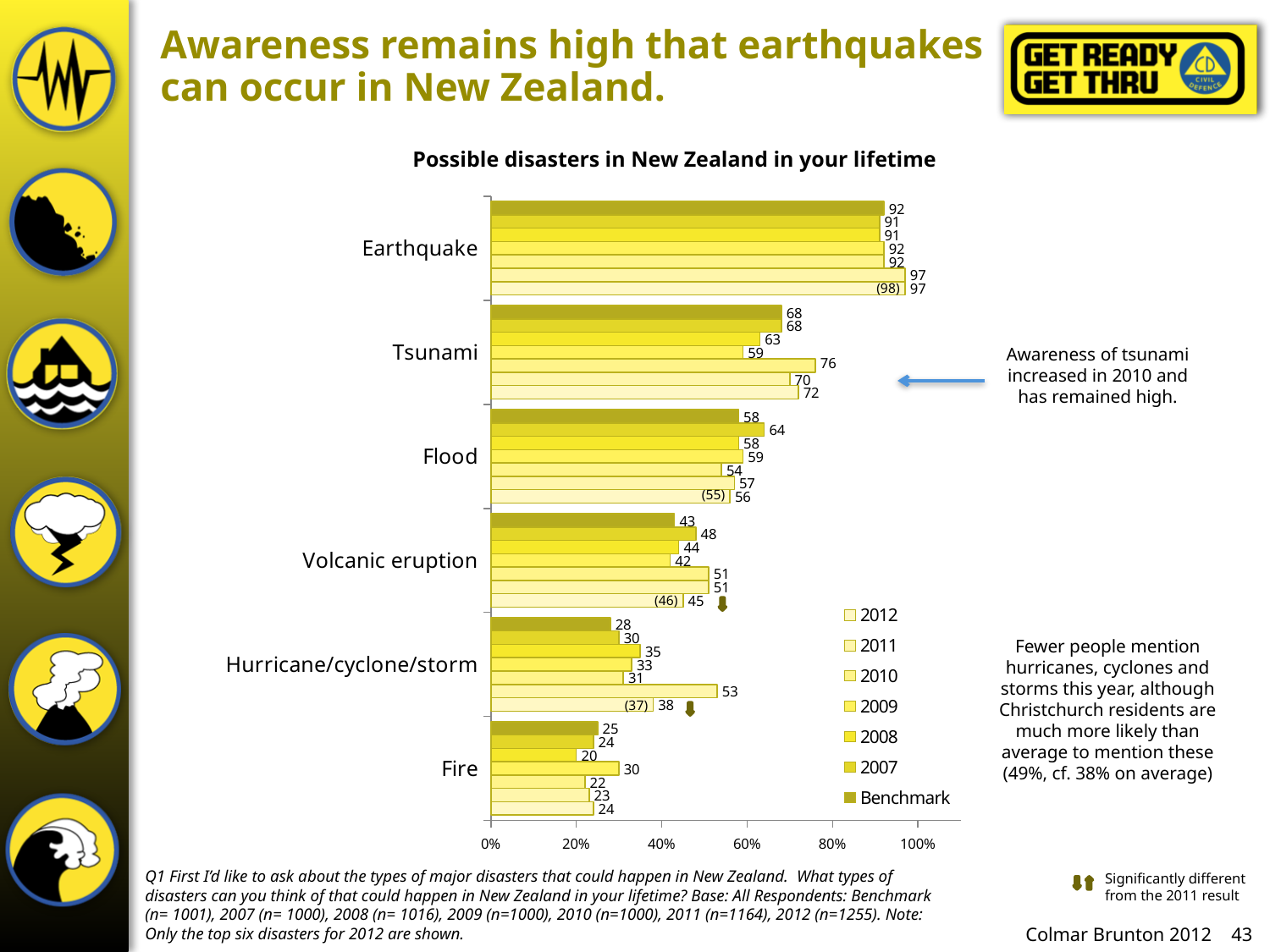
Is the 2012 value for Tsunami larger or smaller than the 2012 value for Flood? larger What is the title of the chart? Possible disasters in New Zealand in your lifetime What is the 2012 value for Earthquake? 97 What is the difference between the 2011 and 2012 values for Hurricane/cyclone/storm? 15 What type of chart is shown on the slide? bar chart Which disaster category has the highest values overall? Earthquake What is the 2011 value for Hurricane/cyclone/storm? 53 How many disaster categories are shown on the chart? 6 What is the 2012 value for Hurricane/cyclone/storm? 38 Which disaster category has the lowest values overall? Fire How many series does the legend list? 7 What is the Benchmark value for Tsunami? 68